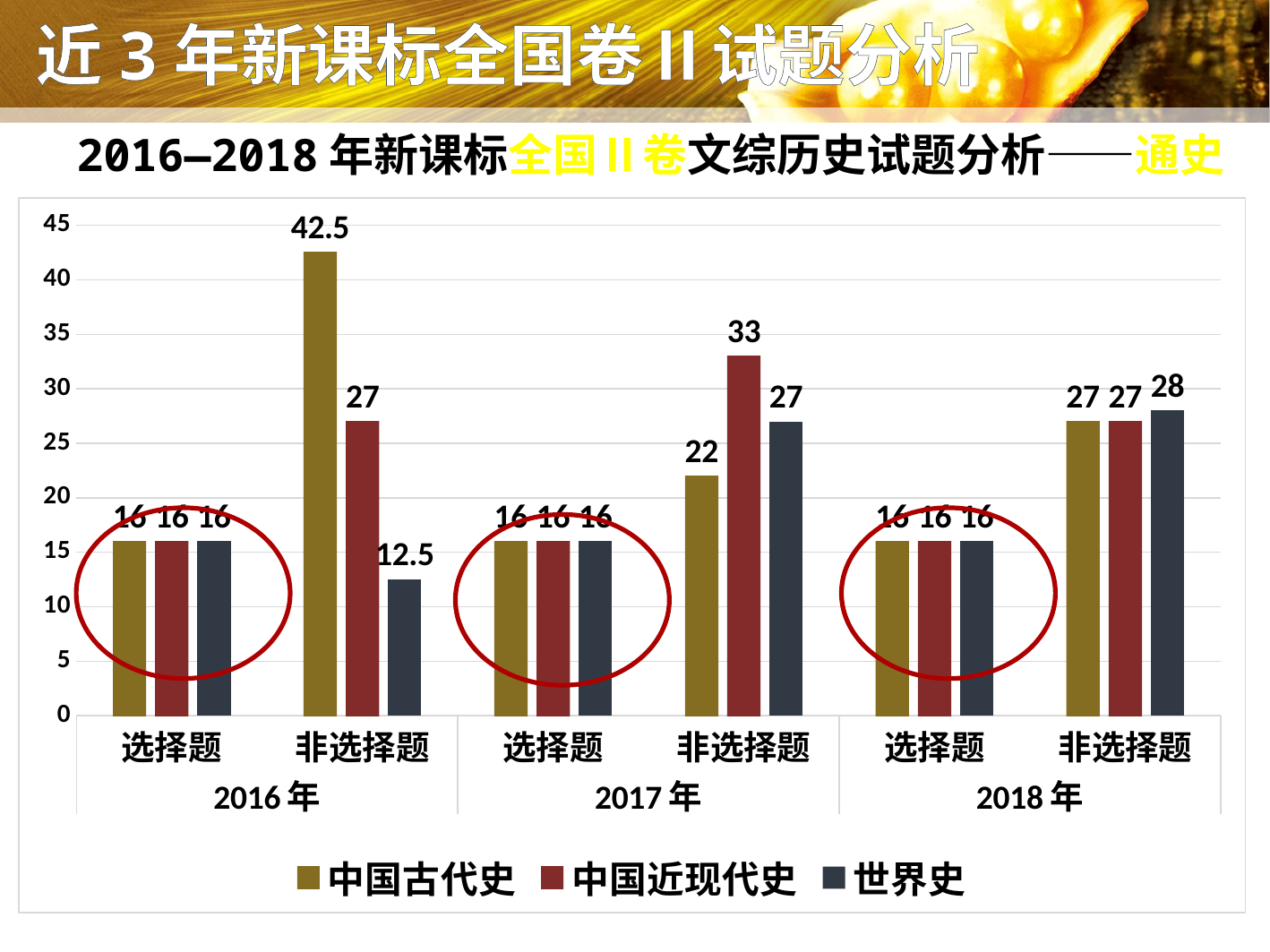
What is the value for 中国古代史 in 非选择题 for 2016年? 42.5 Which is larger in 非选择题 for 2017年: 中国近现代史 or 世界史? 中国近现代史 Which series has the lowest value in 非选择题 for 2017年? 中国古代史 What is the value for 世界史 in 非选择题 for 2018年? 28 What is the value for 中国近现代史 in 非选择题 for 2017年? 33 What is the value for 世界史 in 非选择题 for 2016年? 12.5 How many series does the legend list? 3 What is the difference between 中国古代史 and 世界史 in 非选择题 for 2016年? 30 Which series has the highest value in 非选择题 for 2016年? 中国古代史 What type of chart is shown on the slide? bar chart What is the value for 中国古代史 in 选择题 for 2018年? 16 What is the total of the three series in 非选择题 for 2018年? 82